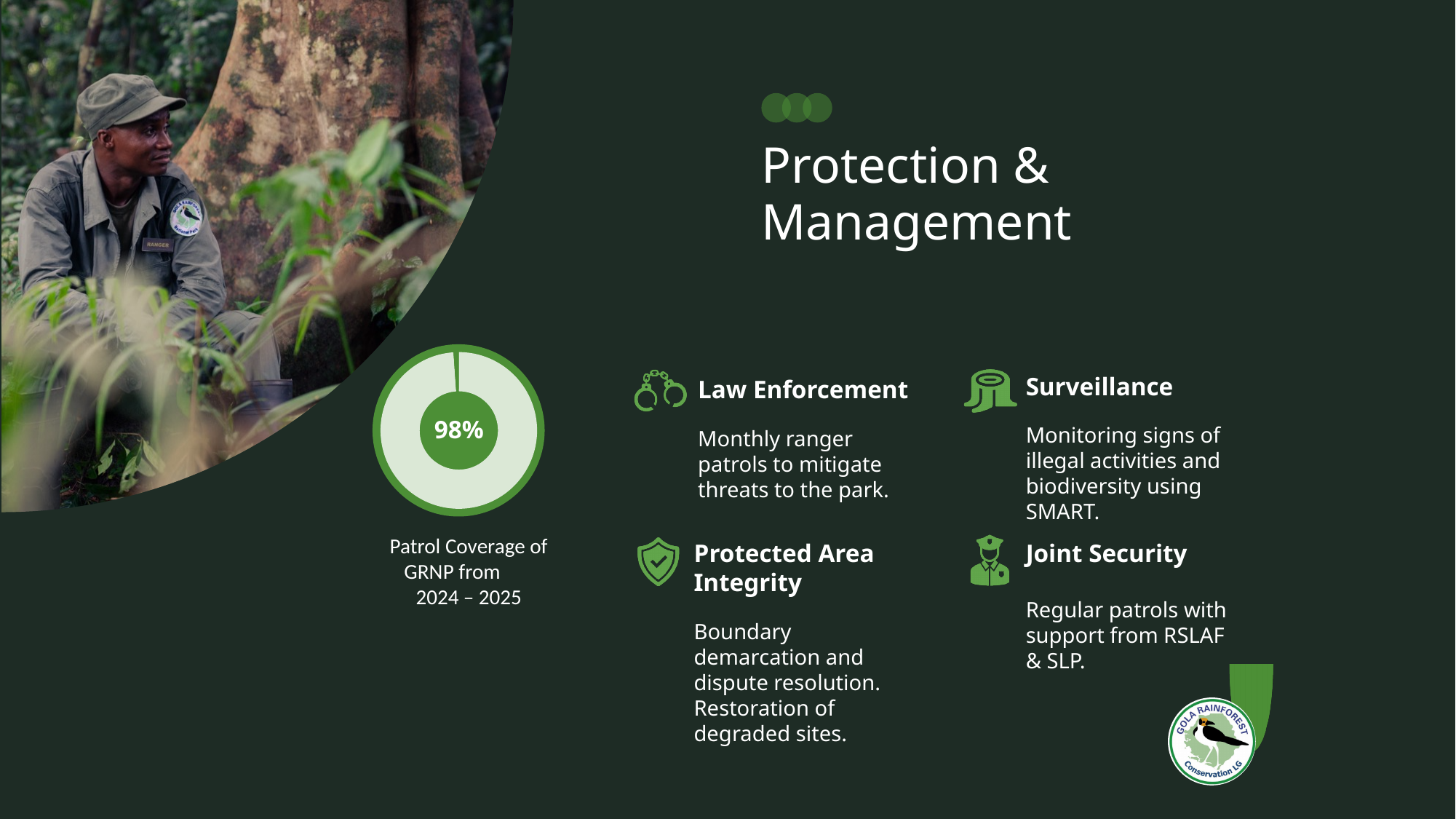
What does the pie chart represent, according to its caption? Patrol Coverage of GRNP from 2024 – 2025 What share of the pie chart is not covered by the 98% patrol coverage slice? 2% What kind of chart is shown on the slide? doughnut chart Is the patrol coverage value shown in the pie chart greater or less than 90%? greater Which period does the patrol coverage pie chart cover? 2024 – 2025 What percentage is printed in the centre of the pie chart? 98% How many slices does the pie chart have? 2 Is the patrol coverage value in the pie chart greater or less than 50%? greater